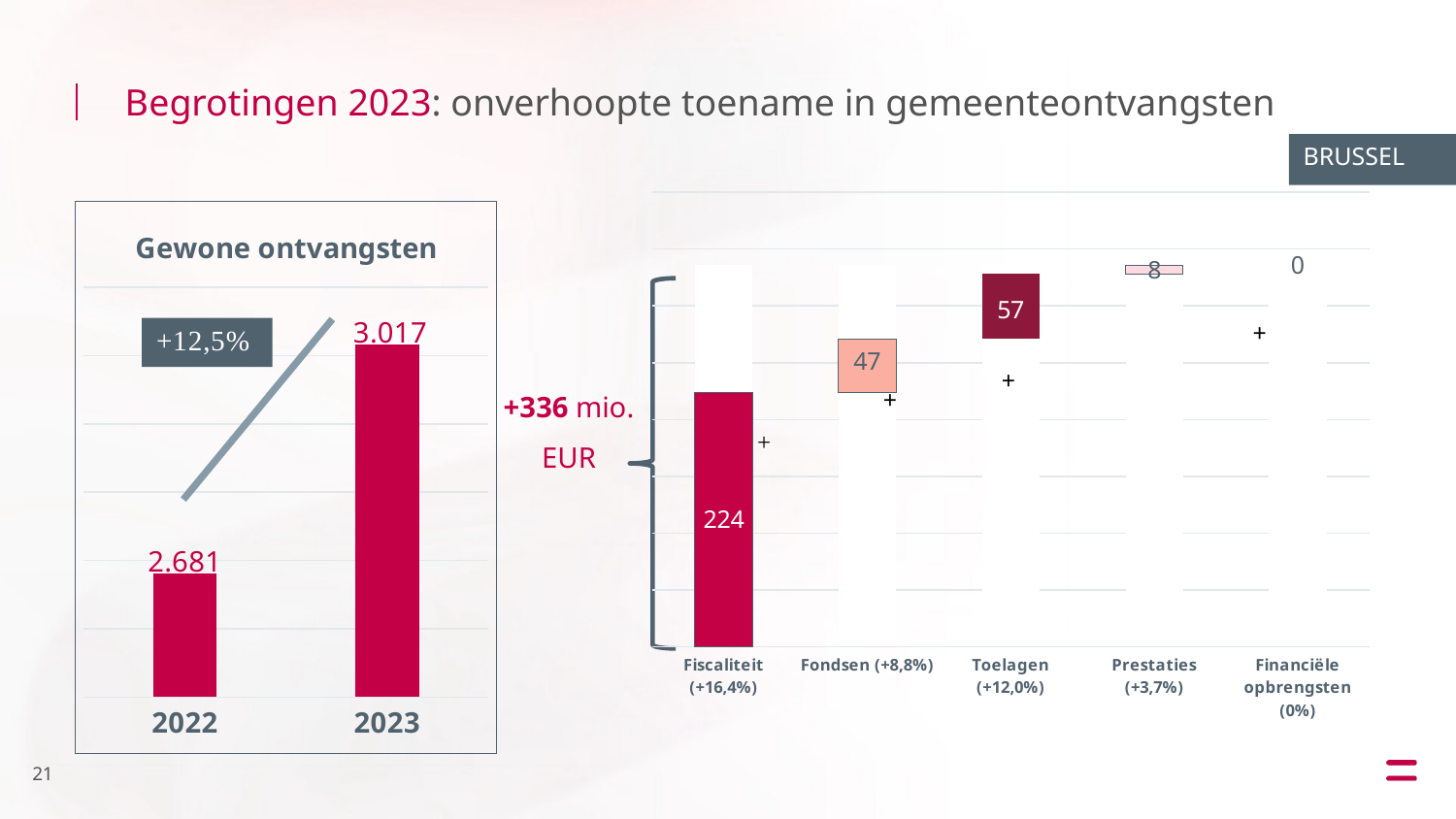
In the 'Gewone ontvangsten' chart, what is the value for 2022? 2.681 In the 'Gewone ontvangsten' chart, which year has the higher value? 2023 How many categories are shown in the chart on the right? 5 In the 'Gewone ontvangsten' chart, what percentage change is shown between 2022 and 2023? +12,5% In the chart on the right, what is the value for Fondsen? 47 In the 'Gewone ontvangsten' chart, what is the value for 2023? 3.017 What kind of chart is the 'Gewone ontvangsten' chart on the left? bar chart In the chart on the right, what is the value for Toelagen? 57 In the chart on the right, which category has the highest value? Fiscaliteit In the chart on the right, which category has the lowest value? Financiële opbrengsten In the 'Gewone ontvangsten' chart, what is the difference between the 2023 and 2022 values? 336 In the chart on the right, what is the value for Fiscaliteit? 224